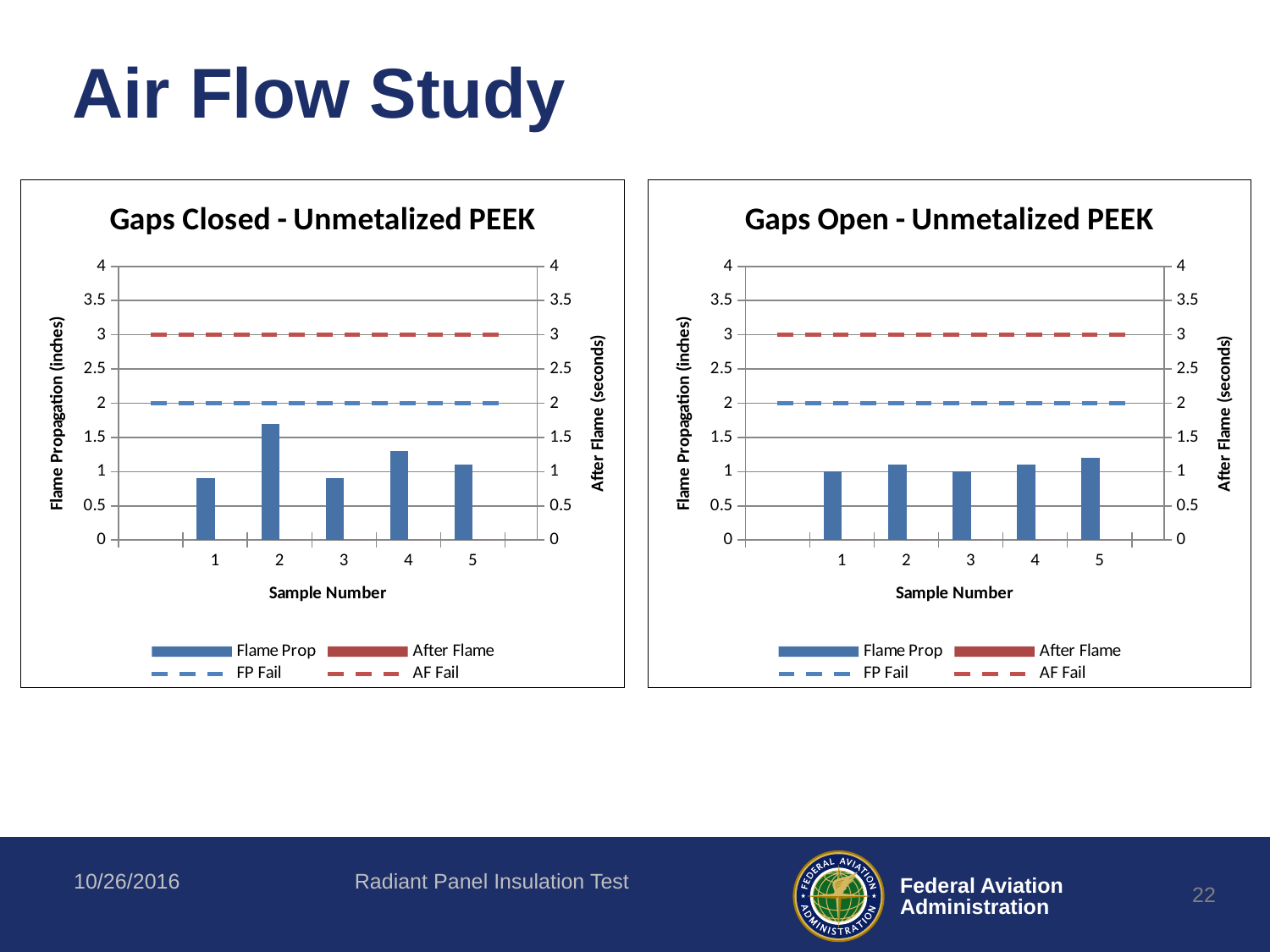
In the 'Gaps Open - Unmetalized PEEK' chart, at what value does the AF Fail dashed line sit? 3 In the 'Gaps Open - Unmetalized PEEK' chart, do any Flame Prop bars reach the FP Fail line at 2? No How many entries does the legend of the 'Gaps Open - Unmetalized PEEK' chart list? 4 What kind of chart is the 'Gaps Closed - Unmetalized PEEK' chart? bar chart In the 'Gaps Closed - Unmetalized PEEK' chart, at what value does the FP Fail dashed line sit? 2 In the 'Gaps Open - Unmetalized PEEK' chart, is the Flame Prop value for sample 5 greater or less than 1.5? less In the 'Gaps Closed - Unmetalized PEEK' chart, how many sample numbers are shown on the x axis? 5 In the 'Gaps Closed - Unmetalized PEEK' chart, is the Flame Prop value for sample 1 greater or less than 1? less In the 'Gaps Closed - Unmetalized PEEK' chart, which sample number has the highest Flame Prop bar? 2 What is the label of the left-hand vertical axis on the 'Gaps Open - Unmetalized PEEK' chart? Flame Propagation (inches) In the 'Gaps Closed - Unmetalized PEEK' chart, is the Flame Prop value for sample 2 greater or less than 1.5? greater In the 'Gaps Closed - Unmetalized PEEK' chart, is the Flame Prop bar for sample 2 or sample 4 taller? sample 2